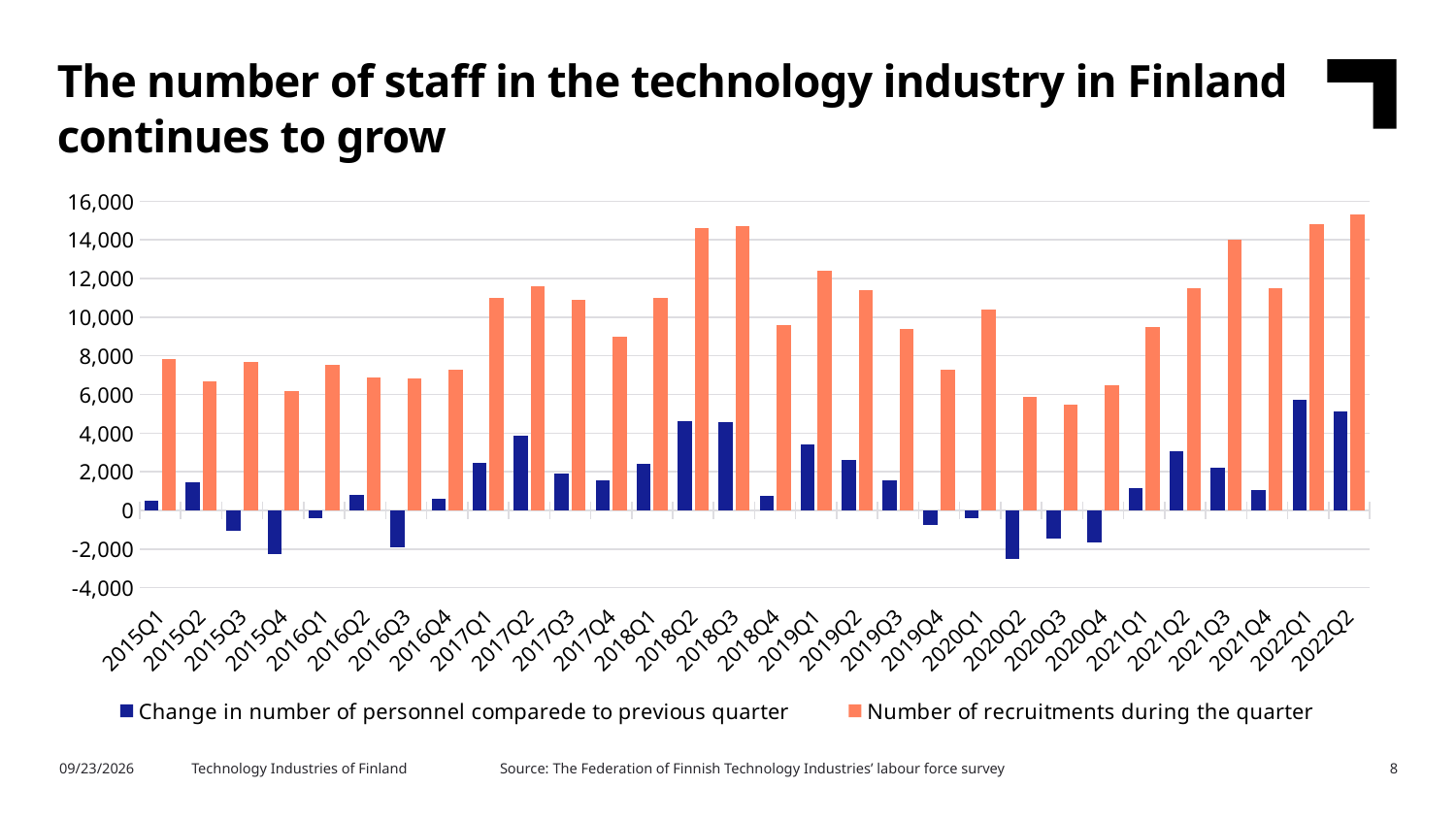
What kind of chart is shown on the slide? bar chart Do the number of recruitments during the quarter rise or fall from 2020Q3 to 2022Q2? rise Which quarter has the highest number of recruitments during the quarter? 2022Q2 Which quarter has the highest change in number of personnel compared to previous quarter? 2022Q1 How many series does the legend list? 2 How many quarters are shown on the x axis? 30 Is the change in number of personnel compared to previous quarter for 2020Q2 greater or less than -2,000? less Is the change in number of personnel compared to previous quarter for 2022Q1 greater or less than 4,000? greater Is the number of recruitments during the quarter for 2020Q3 greater or less than 6,000? less What colour are the bars for the number of recruitments during the quarter? orange Which quarter has more recruitments during the quarter, 2018Q2 or 2015Q1? 2018Q2